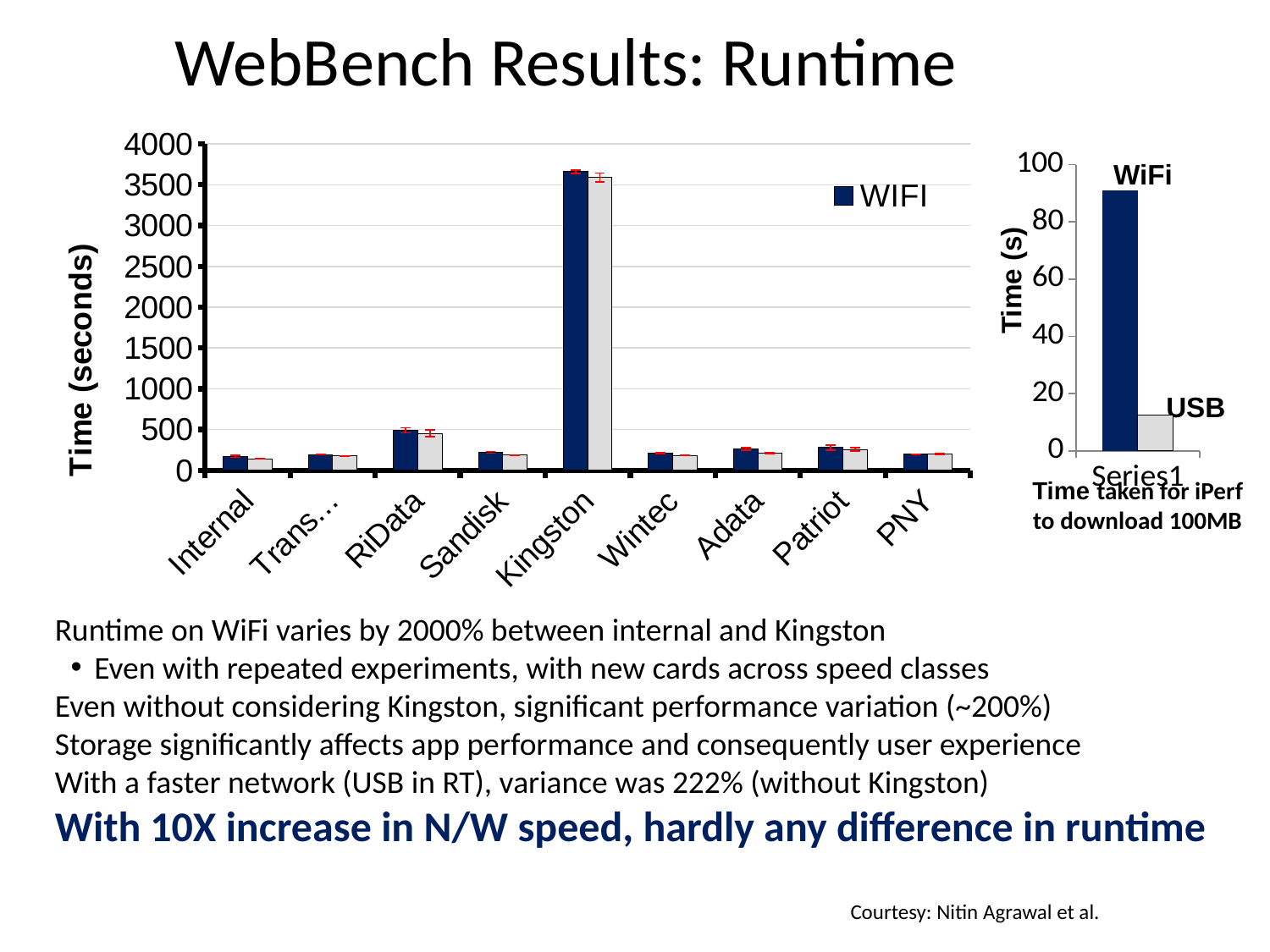
In the small chart on the right (time taken for iPerf to download 100MB), is the USB value greater or less than 20? less What kind of chart is the large chart on the left of the slide? bar chart How many storage card categories are shown on the x axis of the large chart on the left? 9 In the small chart on the right (time taken for iPerf to download 100MB), is the WiFi value greater or less than 80? greater What is the y-axis label of the large chart on the left? Time (seconds) In the large chart on the left, is the WiFi runtime for Internal greater or less than 500 seconds? less How many series does the legend of the large chart on the left list? 1 In the large chart on the left, which has the larger WiFi runtime, RiData or Internal? RiData In the large chart on the left, which storage card has the highest runtime? Kingston In the small chart on the right (time taken for iPerf to download 100MB), which is larger, WiFi or USB? WiFi